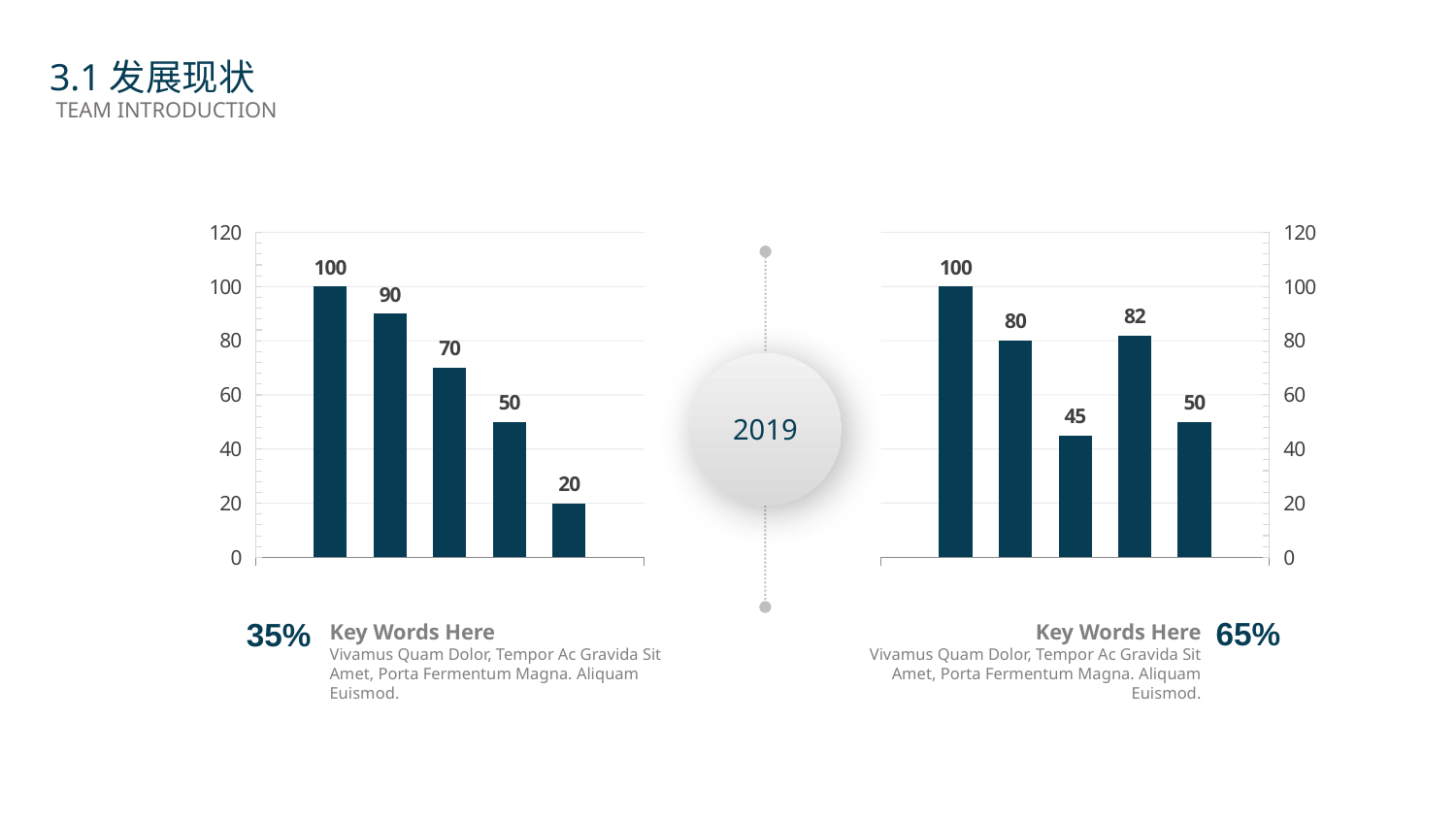
On the right chart, what is the value of the third bar? 45 On the left chart, do the values rise or fall from left to right? fall On the left chart, how many bars are plotted? 5 What kind of chart is the left chart? bar chart On the right chart, which is larger, the second bar or the fourth bar? the fourth bar (82) On the left chart, what is the value of the last (fifth) bar? 20 On the right chart, which bar has the lowest value? the third bar (45) On the left chart, what is the difference between the first bar and the last bar? 80 On the left chart, what is the value of the first bar? 100 On the right chart, what is the value of the fourth bar? 82 On the right chart, how many bars are plotted? 5 On the right chart, what is the difference between the second bar and the third bar? 35